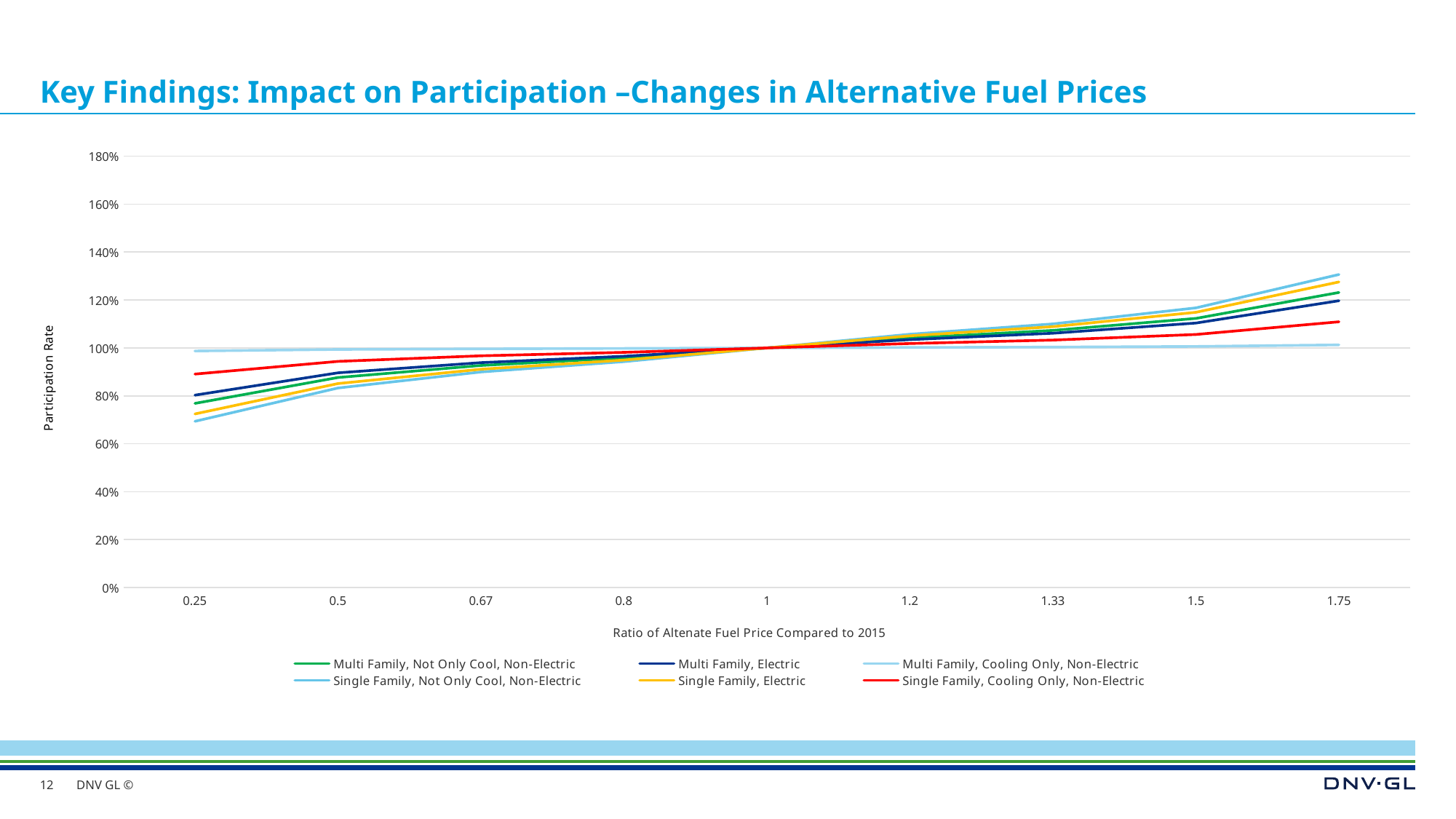
Is the participation rate for Single Family, Electric at a ratio of 0.25 greater or less than 80%? less Is the participation rate for Single Family, Cooling Only, Non-Electric at a ratio of 0.25 greater or less than 80%? greater How many ratio values are shown along the x axis? 9 Does the participation rate for Multi Family, Electric rise or fall as the ratio of alternate fuel price increases from 0.25 to 1.75? Rise At a ratio of 0.25, which has the higher participation rate: Single Family, Cooling Only, Non-Electric or Single Family, Electric? Single Family, Cooling Only, Non-Electric What is the label of the x axis? Ratio of Altenate Fuel Price Compared to 2015 Does the participation rate for Single Family, Cooling Only, Non-Electric rise or fall as the ratio of alternate fuel price increases? Rise Is the participation rate for Multi Family, Electric at a ratio of 1.75 greater or less than 100%? greater How many series does the legend list? 6 What kind of chart is shown on the slide? Line chart At a ratio of 1.75, which has the higher participation rate: Single Family, Electric or Single Family, Cooling Only, Non-Electric? Single Family, Electric